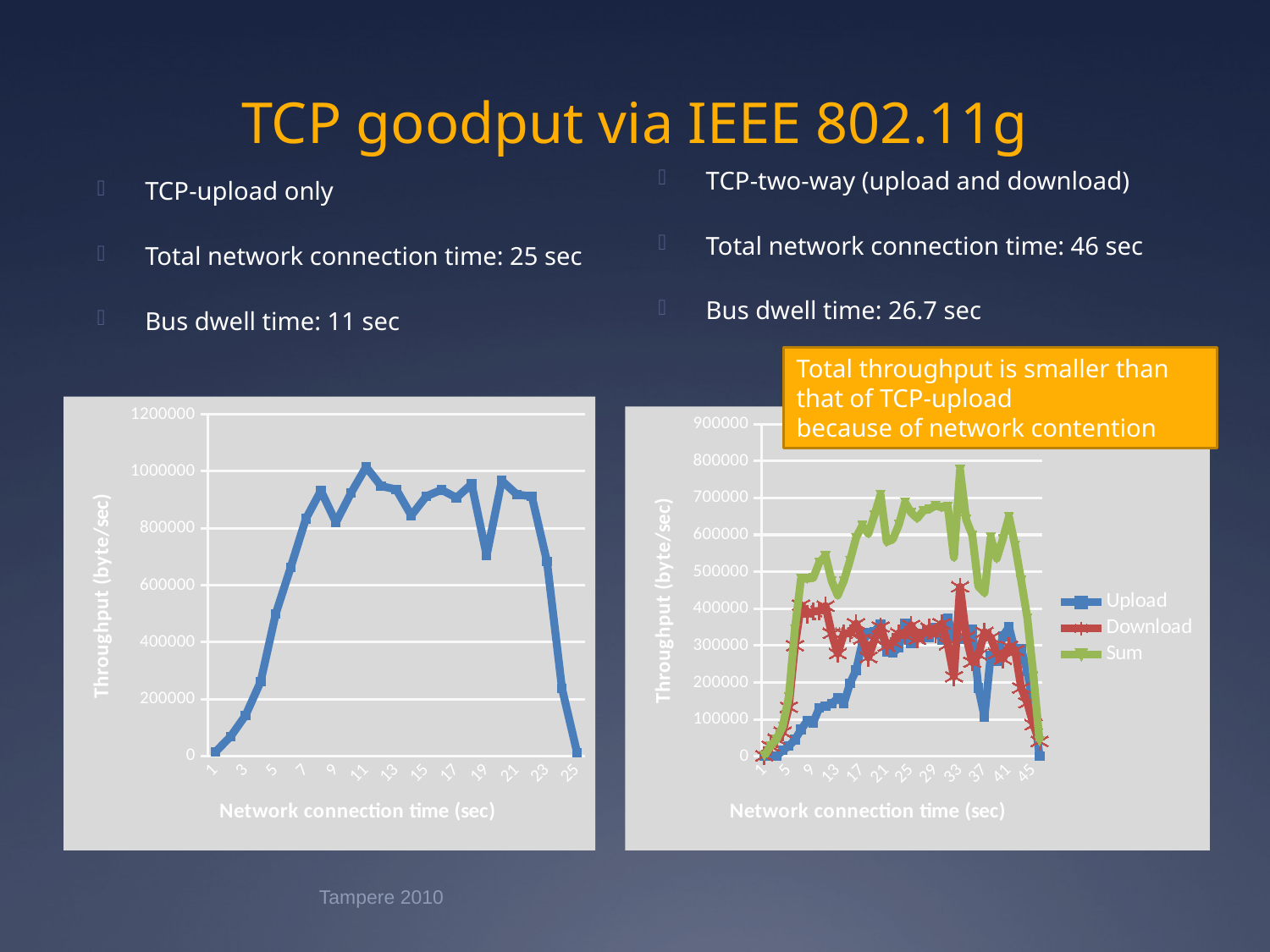
In the left chart, is the throughput at network connection time 5 sec greater or less than 400000? greater What are the series names in the legend of the right chart? Upload, Download, Sum What kind of chart is the right chart (TCP-two-way)? line chart What is the y-axis title of the left chart? Throughput (byte/sec) In the right chart, which series has the highest values overall? Sum What kind of chart is the left chart (TCP-upload only)? line chart In the left chart, is the throughput at network connection time 11 sec greater or less than 800000? greater In the right chart, is the peak value of the Sum series greater or less than 700000? greater In the right chart, at network connection time 5 sec, which is larger: Upload or Download? Download How many series does the legend of the right chart list? 3 In the left chart, does the throughput rise or fall between network connection time 21 sec and 25 sec? fall In the left chart, does the throughput rise or fall between network connection time 1 sec and 11 sec? rise